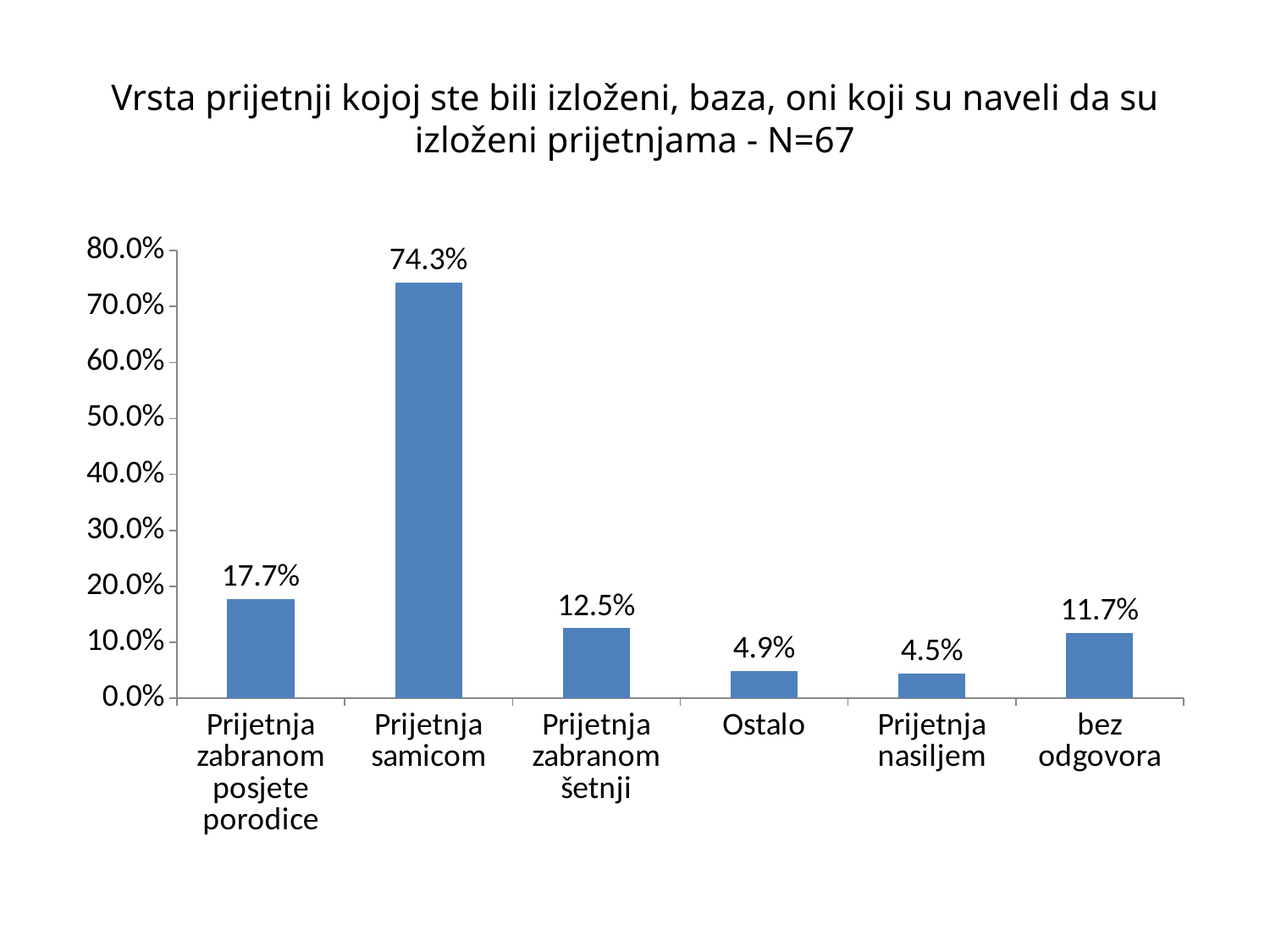
How many categories are shown on the x axis? 6 What kind of chart is shown on the slide? bar chart What is the difference between the values for Prijetnja samicom and Prijetnja zabranom posjete porodice? 56.6% What is the value for bez odgovora? 11.7% Which is larger, the value for Ostalo or the value for bez odgovora? bez odgovora Which category has the lowest value? Prijetnja nasiljem What is the value for Prijetnja samicom? 74.3% Which category has the highest value? Prijetnja samicom What is the difference between the values for Prijetnja zabranom šetnji and bez odgovora? 0.8% What is the value for Prijetnja zabranom posjete porodice? 17.7% What is the sample size (N) stated in the chart title? N=67 Is the value for Prijetnja zabranom šetnji greater or less than 10.0%? greater